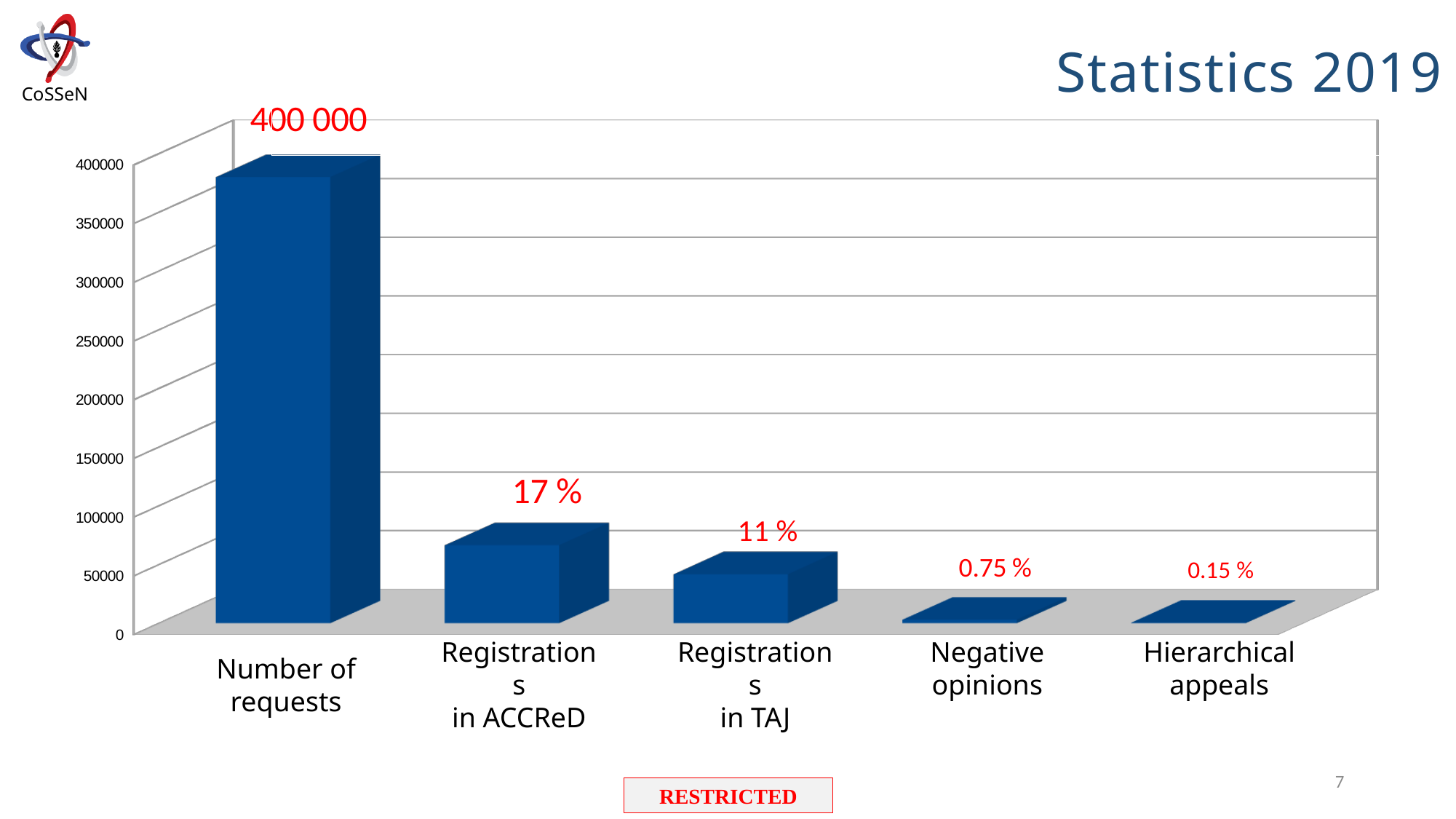
What label is shown above the bar for Number of requests? 400 000 Which category has the shortest bar? Hierarchical appeals What label is shown above the bar for Registrations in TAJ? 11 % Is the value for Number of requests greater or less than 350000? greater Is the value for Registrations in ACCReD greater or less than 100000? less What is the title of the slide containing the chart? Statistics 2019 What label is shown above the bar for Negative opinions? 0.75 % What label is shown above the bar for Registrations in ACCReD? 17 % How many categories are shown on the chart? 5 What label is shown above the bar for Hierarchical appeals? 0.15 % Which bar is taller: Registrations in ACCReD or Registrations in TAJ? Registrations in ACCReD Which category has the tallest bar? Number of requests